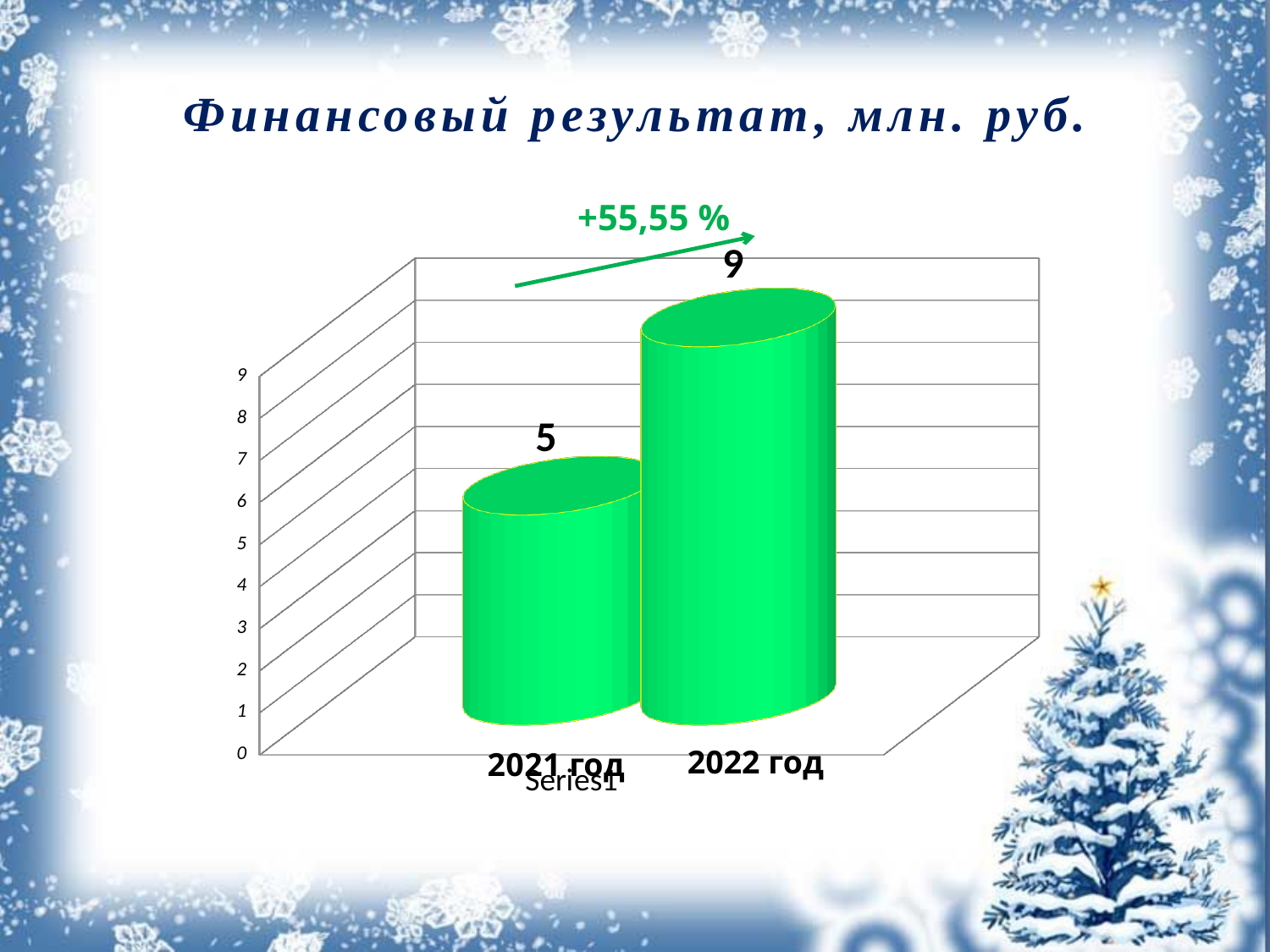
What kind of chart is shown on the slide? bar chart Is the value for 2021 год greater or less than 4? greater What is the financial result for 2021 год? 5 Which year has the higher financial result? 2022 год How many categories are shown on the chart? 2 What is the difference between the financial result for 2022 год and 2021 год? 4 Is the value for 2022 год larger or smaller than the value for 2021 год? larger Do the values rise or fall from 2021 год to 2022 год? rise What percentage change is annotated above the bars? +55,55 % Which year has the lower financial result? 2021 год What is the financial result for 2022 год? 9 What is the title of the chart? Финансовый результат, млн. руб.